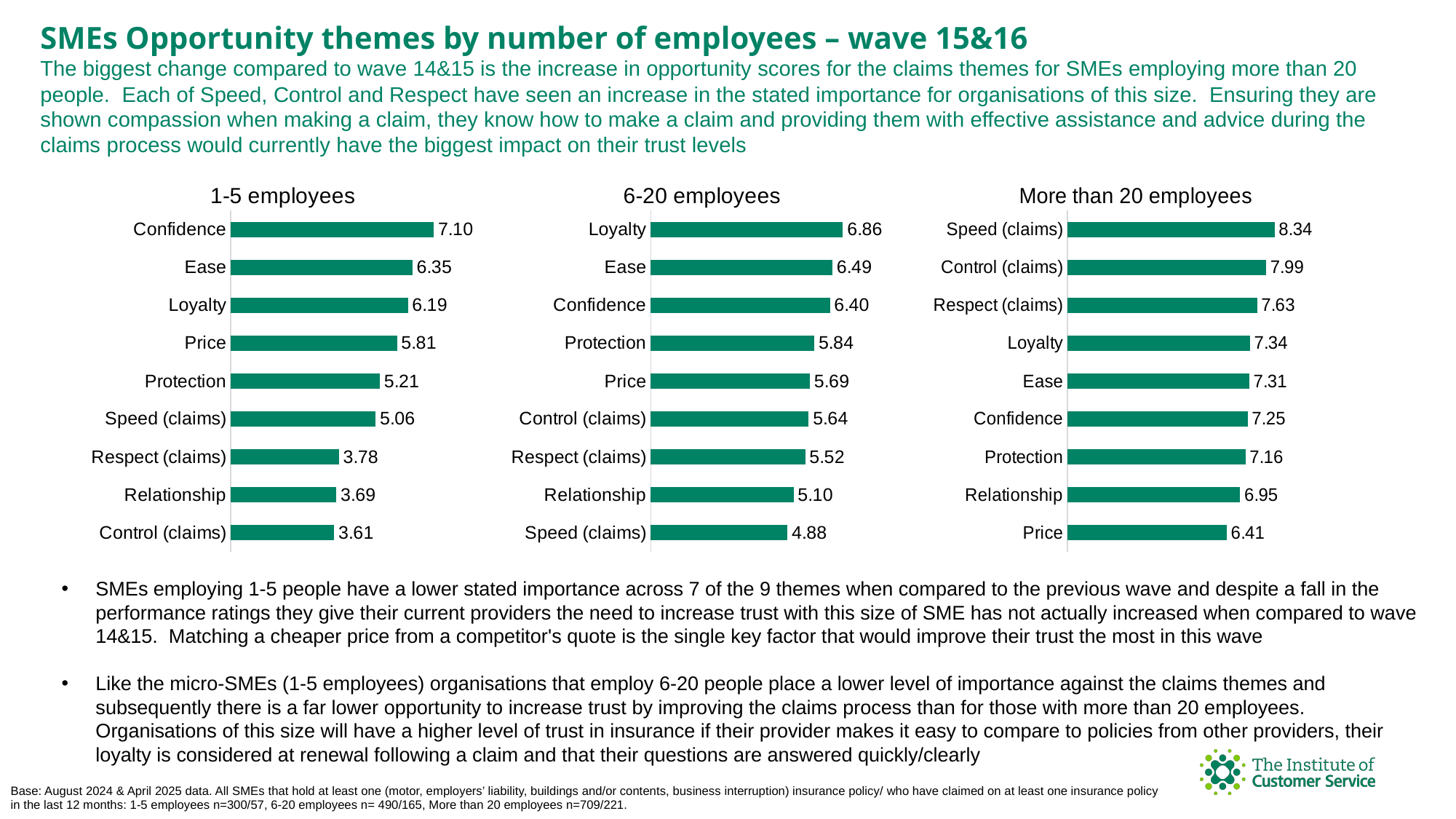
In the 'More than 20 employees' chart, which theme has the highest value? Speed (claims) How many themes are shown in the '1-5 employees' chart? 9 In the 'More than 20 employees' chart, what is the difference between Speed (claims) and Control (claims)? 0.35 In the '6-20 employees' chart, which is larger, Loyalty or Ease? Loyalty What kind of chart is the '6-20 employees' chart? Bar chart In the '6-20 employees' chart, which theme has the lowest value? Speed (claims) In the '1-5 employees' chart, which theme has the lowest value? Control (claims) In the '6-20 employees' chart, what is the value for Protection? 5.84 How many charts are shown on the slide? 3 In the '1-5 employees' chart, what is the difference between Confidence and Ease? 0.75 In the '1-5 employees' chart, what is the value for Confidence? 7.10 In the 'More than 20 employees' chart, what is the value for Price? 6.41